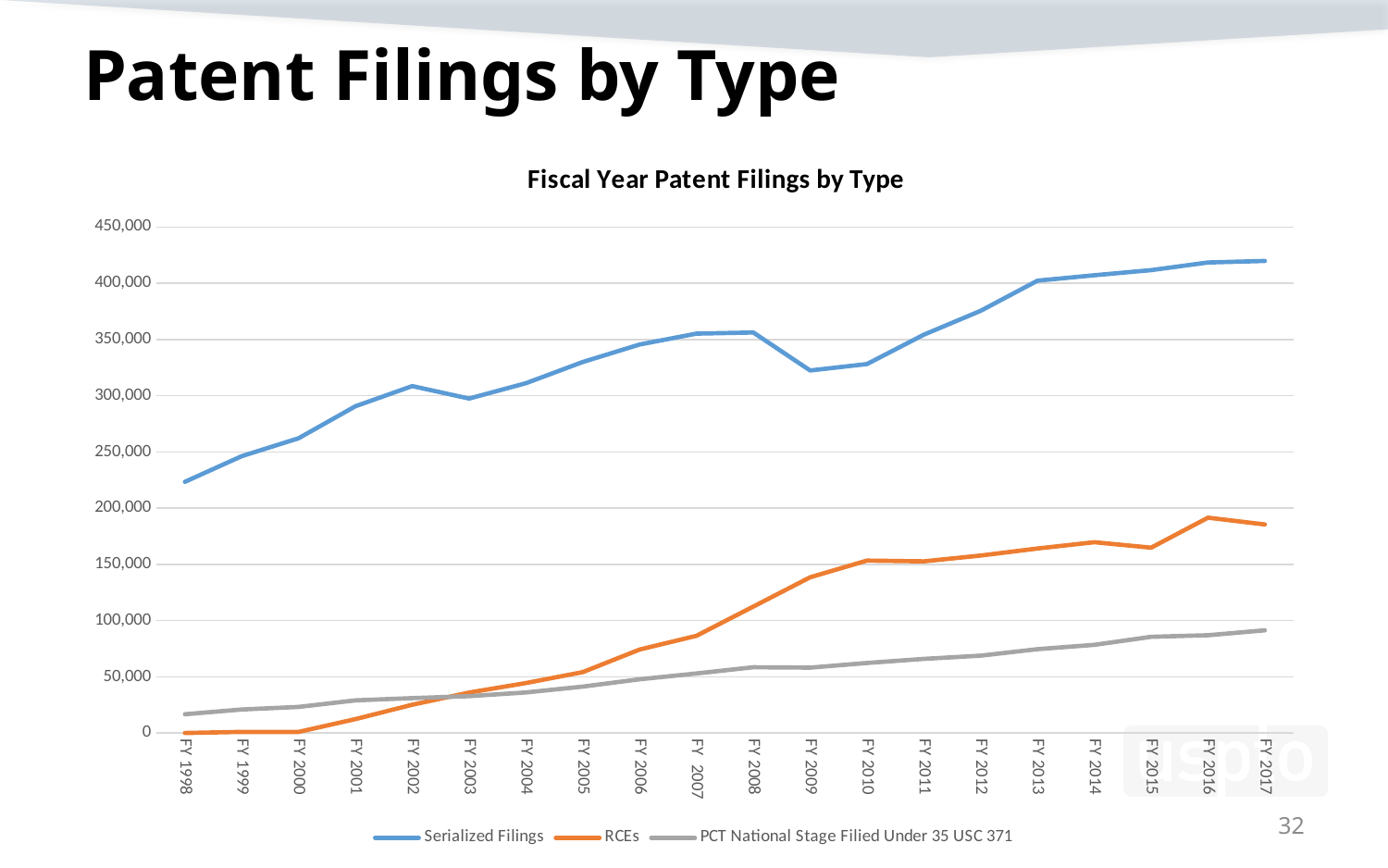
Is the value for Serialized Filings in FY 2017 greater or less than 400,000? greater Which series is drawn in orange? RCEs What kind of chart is shown on the slide? line chart How many series does the legend list? 3 In FY 2000, which is larger: RCEs or PCT National Stage Filied Under 35 USC 371? PCT National Stage Filied Under 35 USC 371 In which fiscal year is the Serialized Filings value lowest? FY 1998 Is the value for RCEs in FY 2016 greater or less than 150,000? greater Is the value for PCT National Stage Filied Under 35 USC 371 in FY 2017 greater or less than 100,000? less In which fiscal year is the RCEs value highest? FY 2016 How many fiscal years are plotted along the x axis? 20 What is the title of the chart? Fiscal Year Patent Filings by Type